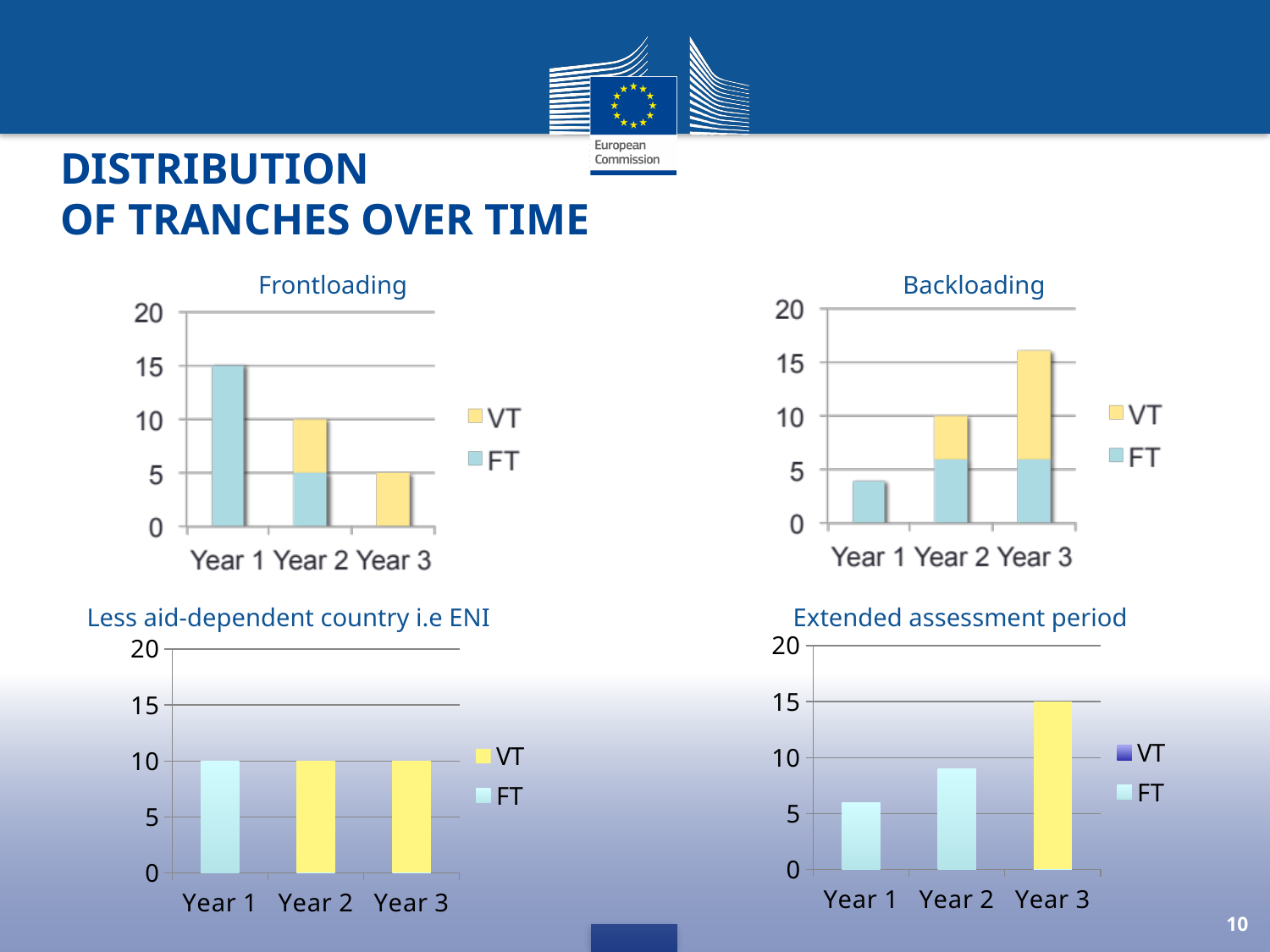
What kind of chart is the 'Extended assessment period' chart? bar chart How many series does the legend of the Backloading chart list? 2 In the 'Extended assessment period' chart, is the value for Year 2 greater or less than 10? less In the Backloading chart, is the value for Year 1 greater or less than 5? less In the 'Extended assessment period' chart, what is the value for Year 3? 15 In the Backloading chart, which year has the lowest bar? Year 1 In the 'Less aid-dependent country i.e ENI' chart, what is the value for Year 2? 10 In the Frontloading chart, which year has the highest bar? Year 1 In the Frontloading chart, what is the total height of the stacked bar for Year 2? 10 In the Frontloading chart, do the bar totals rise or fall from Year 1 to Year 3? fall In the Frontloading chart, what is the value of the FT bar for Year 1? 15 In the Backloading chart, is the total for Year 3 greater or less than 15? greater